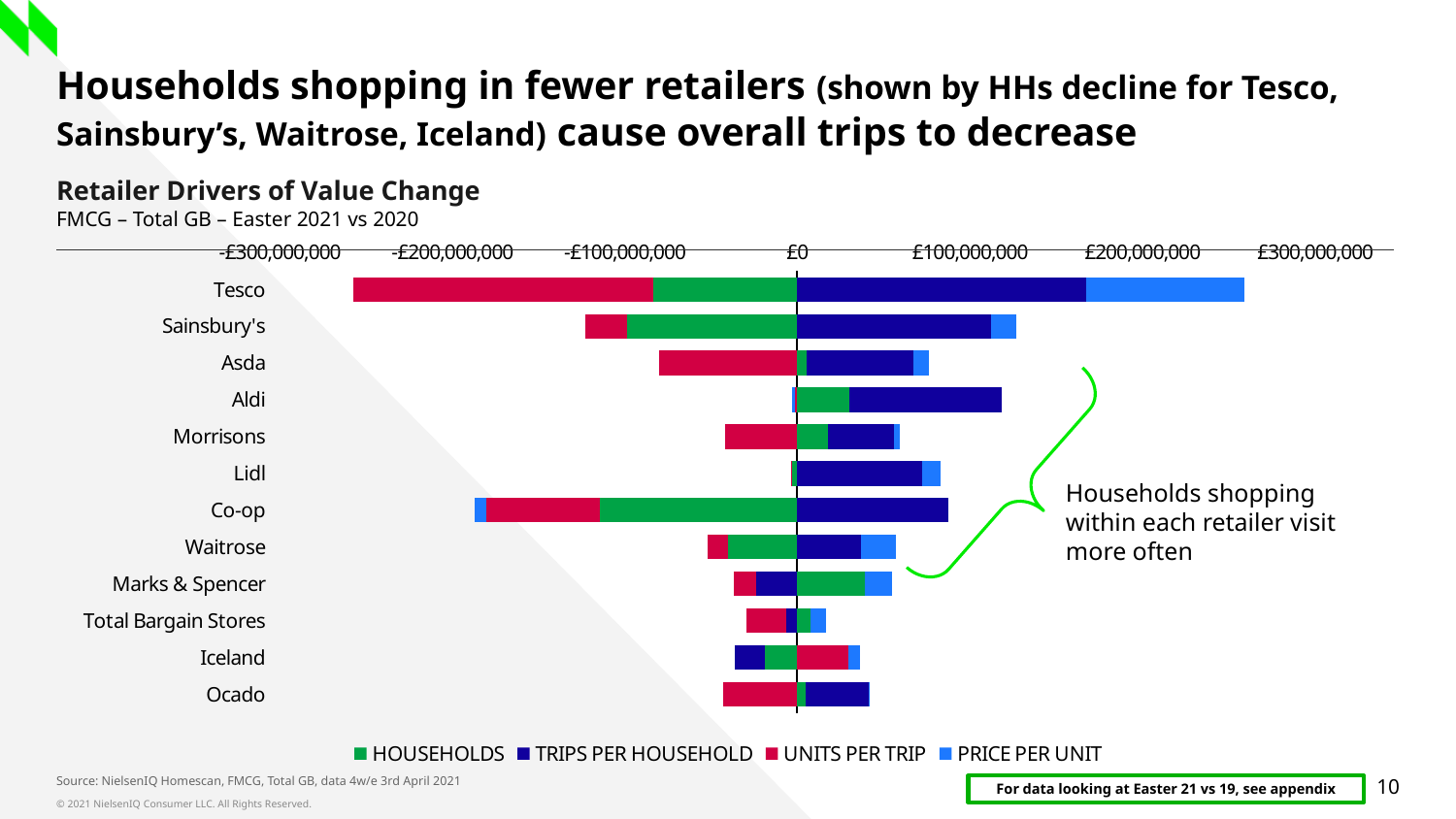
How many series does the legend list? 4 Which series is shown in green in the legend? HOUSEHOLDS What kind of chart is shown on the slide? Stacked horizontal bar chart Which retailer has the largest negative Households segment? Co-op Is the Households value for Co-op greater or less than -£100,000,000? less How many retailers are listed on the chart? 12 Which has the larger Trips per Household segment, Tesco or Ocado? Tesco What is the title of the chart? Retailer Drivers of Value Change Which retailer has the largest Trips per Household segment? Tesco Is the Trips per Household value for Tesco greater or less than £100,000,000? greater Is the Units per Trip value for Tesco greater or less than -£100,000,000? less Which retailer is listed first (at the top) on the chart? Tesco